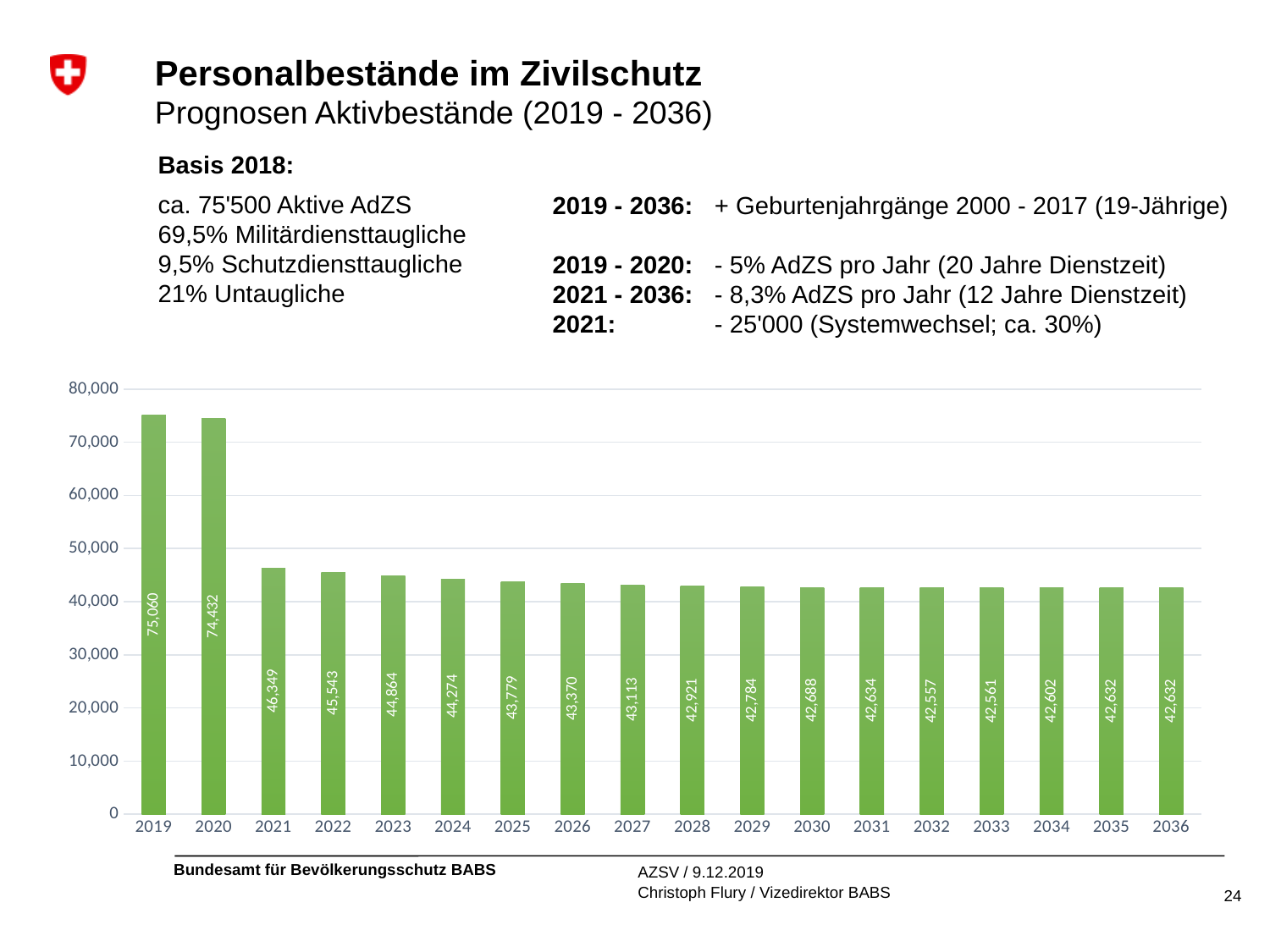
What is the value for 2019? 75,060 Which year has the highest value? 2019 Do the values generally rise or fall from 2019 to 2036? fall What is the value for 2021? 46,349 Which is larger, the value for 2022 or the value for 2023? 2022 What is the value for 2028? 42,921 What kind of chart is shown on the slide? bar chart How many years are shown on the x axis? 18 What is the difference between the values for 2020 and 2021? 28,083 Is the value for 2021 greater or less than 50,000? less What is the value for 2036? 42,632 What is the difference between the values for 2019 and 2020? 628